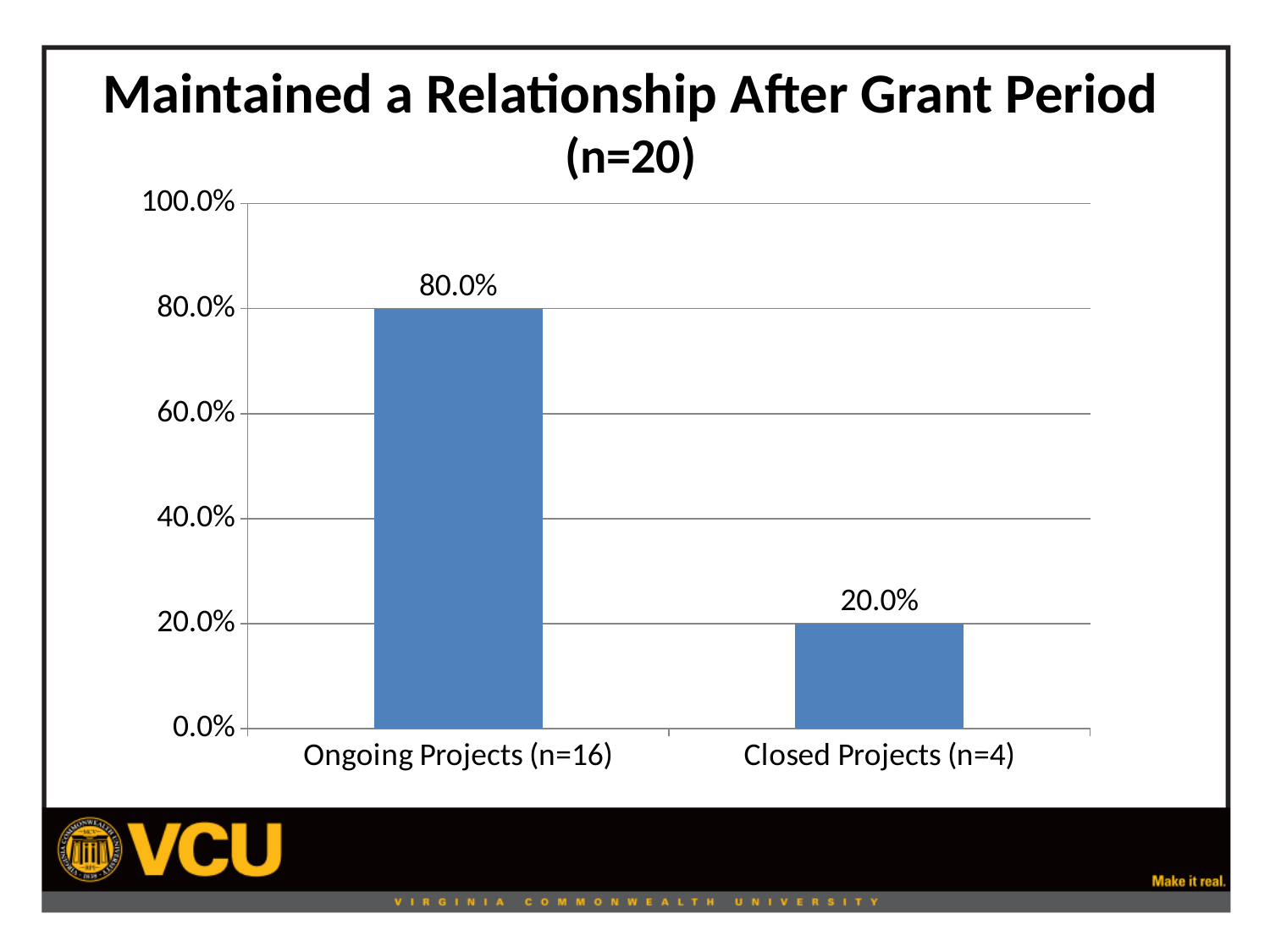
Is the value for Closed Projects (n=4) greater or less than 40.0%? less What is the title of the chart? Maintained a Relationship After Grant Period (n=20) What is the value for Ongoing Projects (n=16)? 80.0% Which category has the lowest value? Closed Projects (n=4) How many categories are shown on the x axis? 2 What is the value for Closed Projects (n=4)? 20.0% Which is larger, the value for Ongoing Projects (n=16) or Closed Projects (n=4)? Ongoing Projects (n=16) What is the maximum value shown on the y axis? 100.0% What kind of chart is shown on the slide? Bar chart Is the value for Ongoing Projects (n=16) greater or less than 60.0%? greater Which category has the highest value? Ongoing Projects (n=16) What is the difference between the values for Ongoing Projects (n=16) and Closed Projects (n=4)? 60.0%